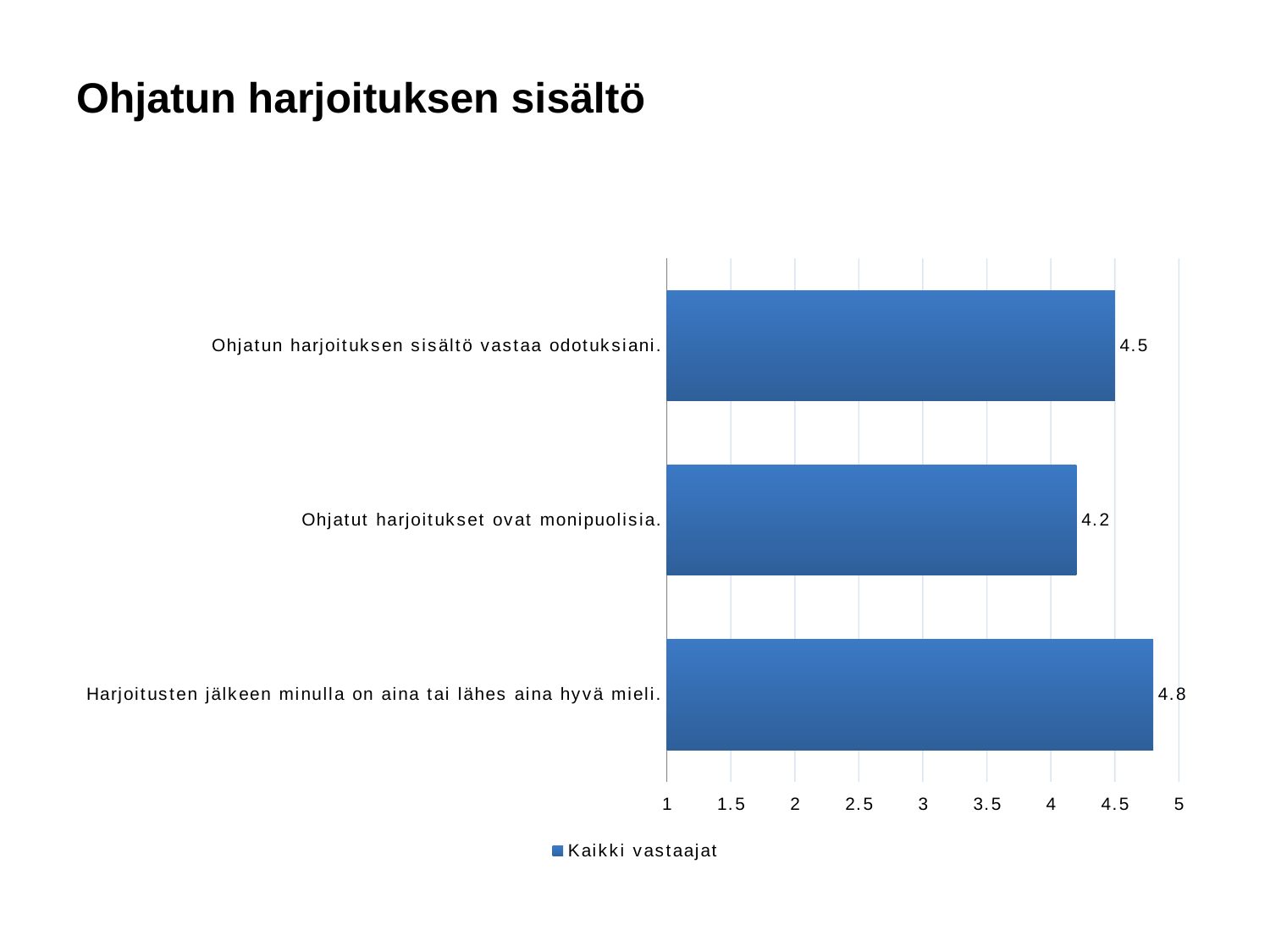
Is the value for "Ohjatut harjoitukset ovat monipuolisia." greater or less than 4.5? less How many series does the legend list? 1 What is the value for "Ohjatun harjoituksen sisältö vastaa odotuksiani."? 4.5 Which category has the highest value? Harjoitusten jälkeen minulla on aina tai lähes aina hyvä mieli. What is the value for "Ohjatut harjoitukset ovat monipuolisia."? 4.2 Which category has the lowest value? Ohjatut harjoitukset ovat monipuolisia. Which is larger: the value for "Ohjatun harjoituksen sisältö vastaa odotuksiani." or for "Ohjatut harjoitukset ovat monipuolisia."? Ohjatun harjoituksen sisältö vastaa odotuksiani. What is the difference between the values for "Ohjatun harjoituksen sisältö vastaa odotuksiani." and "Ohjatut harjoitukset ovat monipuolisia."? 0.3 How many categories are shown in the chart? 3 What kind of chart is shown on the slide? Bar chart What is the difference between the values for "Harjoitusten jälkeen minulla on aina tai lähes aina hyvä mieli." and "Ohjatut harjoitukset ovat monipuolisia."? 0.6 What is the value for "Harjoitusten jälkeen minulla on aina tai lähes aina hyvä mieli."? 4.8